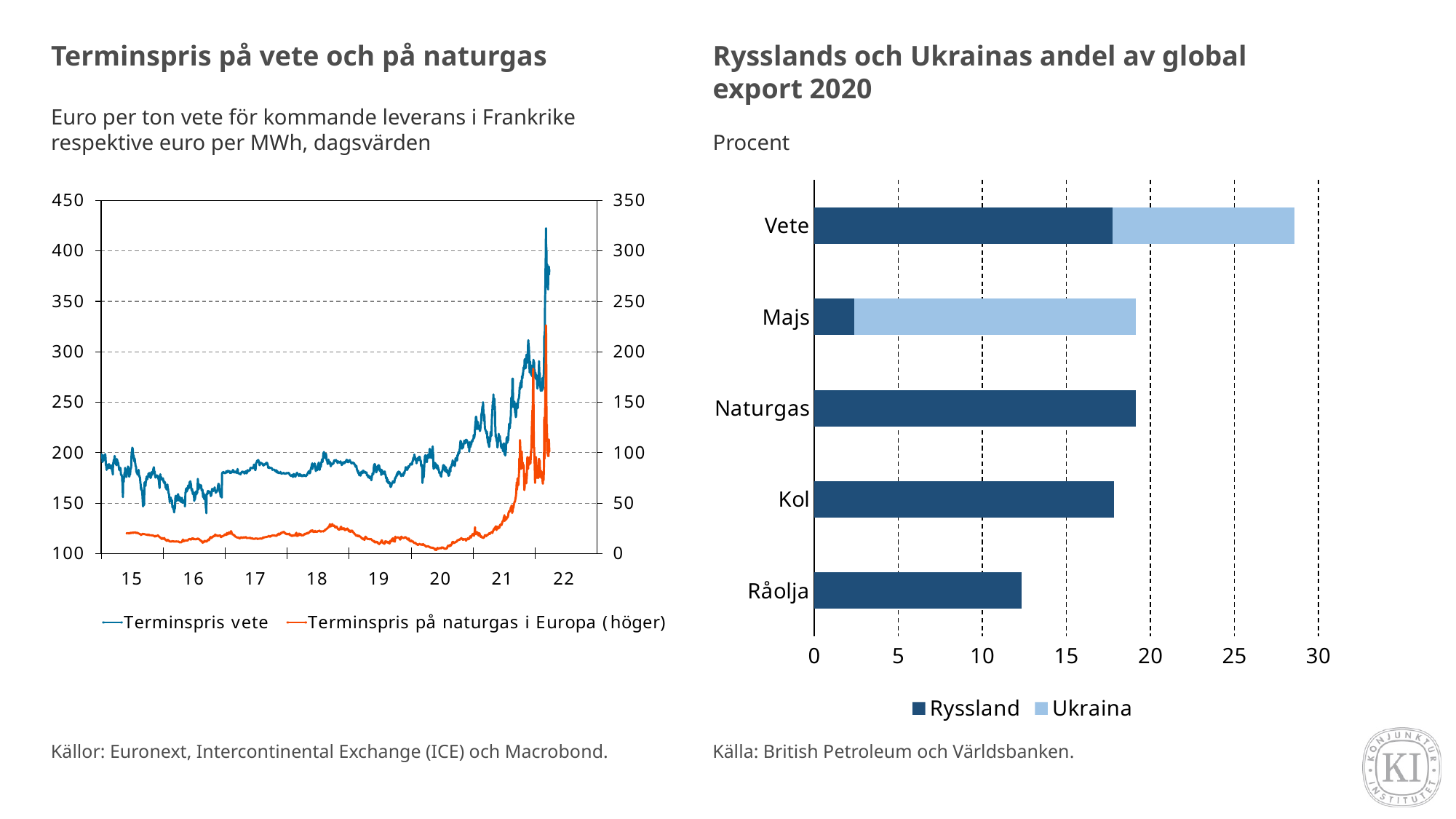
In the right chart, 'Rysslands och Ukrainas andel av global export 2020', which is larger, the bar for Kol or the bar for Råolja? Kol How many series does the legend of the left chart, 'Terminspris på vete och på naturgas', list? 2 In the left chart, 'Terminspris på vete och på naturgas', is the value of 'Terminspris på naturgas i Europa' at 19 greater or less than 50 on the right axis? less How many series does the legend of the right chart, 'Rysslands och Ukrainas andel av global export 2020', list? 2 In the left chart, 'Terminspris på vete och på naturgas', does the 'Terminspris vete' series overall rise or fall from 15 to 22? rise In the left chart, 'Terminspris på vete och på naturgas', is the value of 'Terminspris vete' at 16 greater or less than 200? less In the right chart, 'Rysslands och Ukrainas andel av global export 2020', which category has the lowest combined share? Råolja In the right chart, 'Rysslands och Ukrainas andel av global export 2020', which category has the highest combined share? Vete How many categories are shown in the right chart, 'Rysslands och Ukrainas andel av global export 2020'? 5 In the right chart, 'Rysslands och Ukrainas andel av global export 2020', is the value for Naturgas greater or less than 15? greater What kind of chart is the left chart, 'Terminspris på vete och på naturgas'? line chart What kind of chart is the right chart, 'Rysslands och Ukrainas andel av global export 2020'? bar chart